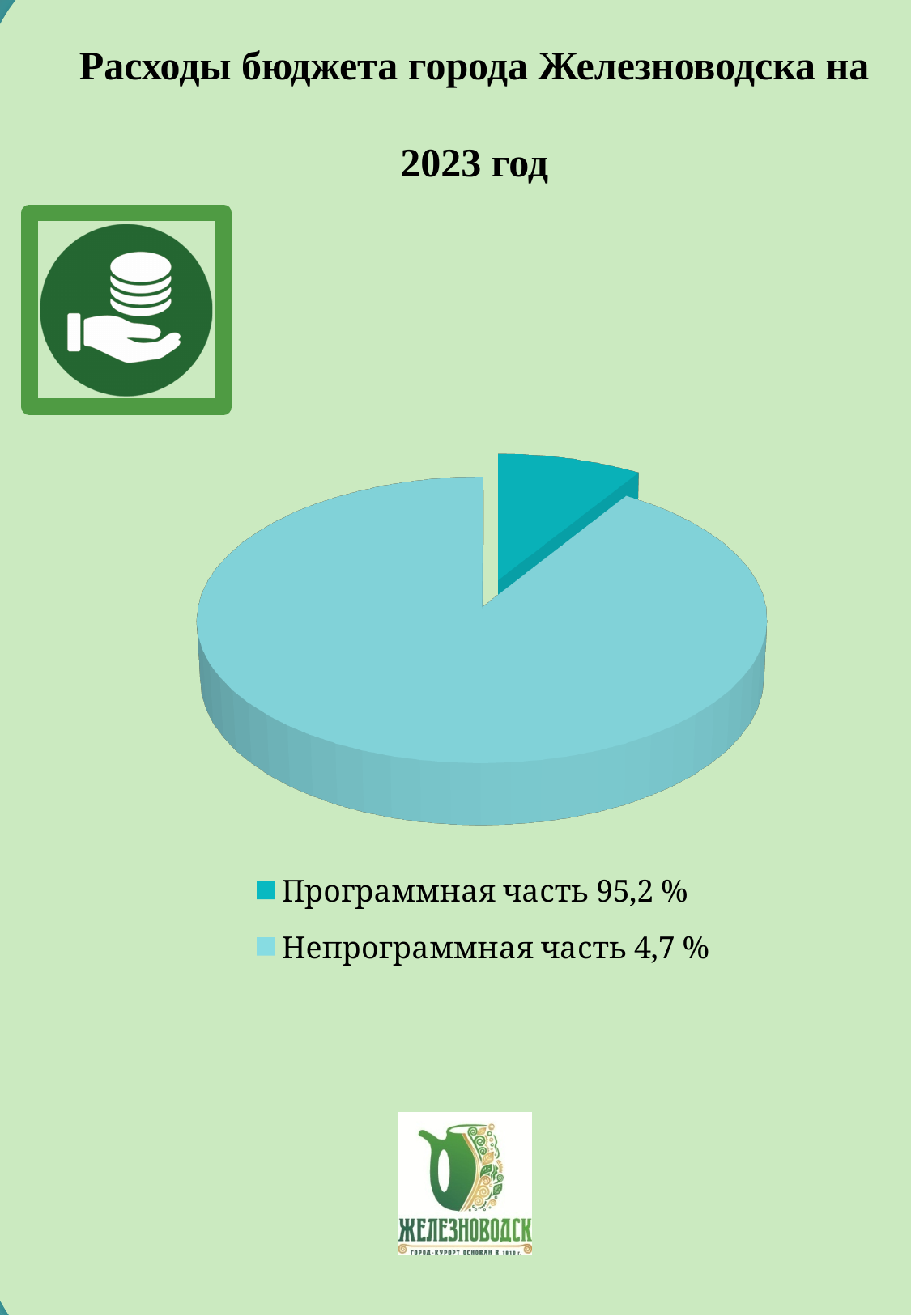
What type of chart is shown on the slide? Pie chart What percentage is shown in the legend for Программная часть? 95,2 % According to the legend, which category has the larger percentage? Программная часть According to the legend, which category has the smaller percentage? Непрограммная часть What is the title of the chart on the slide? Расходы бюджета города Железноводска на 2023 год Which year does the chart title refer to? 2023 How many categories does the pie chart's legend list? 2 According to the legend values, what is the difference in percentage points between Программная часть and Непрограммная часть? 90,5 Is the legend value for Программная часть greater or less than 90 %? greater What percentage is shown in the legend for Непрограммная часть? 4,7 % Is the legend value for Непрограммная часть greater or less than 10 %? less